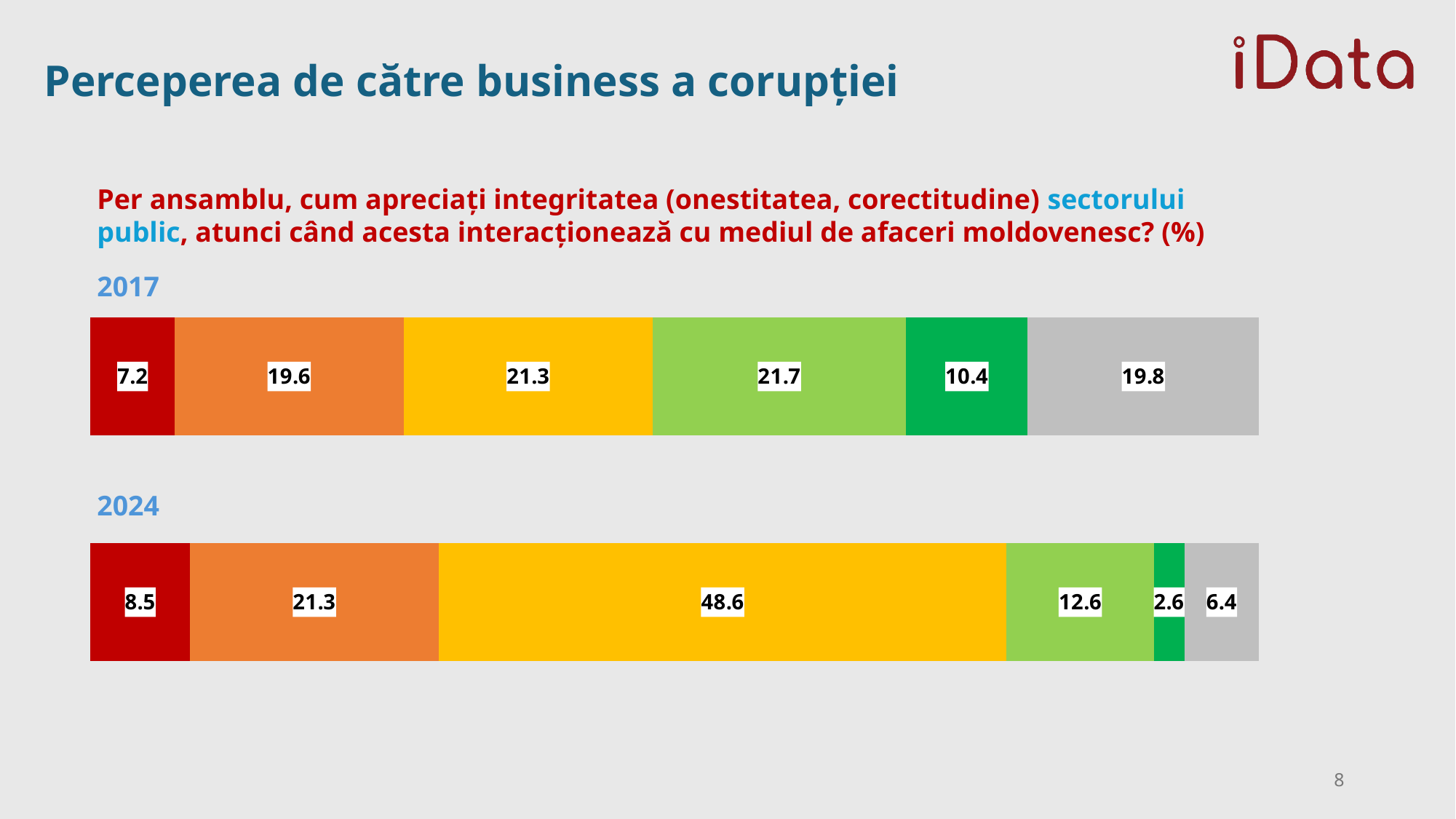
In the 2024 bar, what value is shown on the dark green segment? 2.6 What is the difference between the yellow segment values in 2024 and 2017? 27.3 How many segments does each stacked bar contain? 6 In the 2017 bar, what value is shown on the grey segment? 19.8 Which segment of the 2024 bar has the largest value? the yellow segment (48.6) Which two years are compared on the slide? 2017 and 2024 In the 2017 bar, what value is shown on the red segment? 7.2 Which is larger: the grey segment in 2017 or the grey segment in 2024? 2017 (19.8) What is the total of all segments in the 2024 bar? 100.0 What kind of chart is shown on the slide? stacked bar chart In the 2024 bar, what value is shown on the yellow segment? 48.6 Which segment of the 2017 bar has the smallest value? the red segment (7.2)